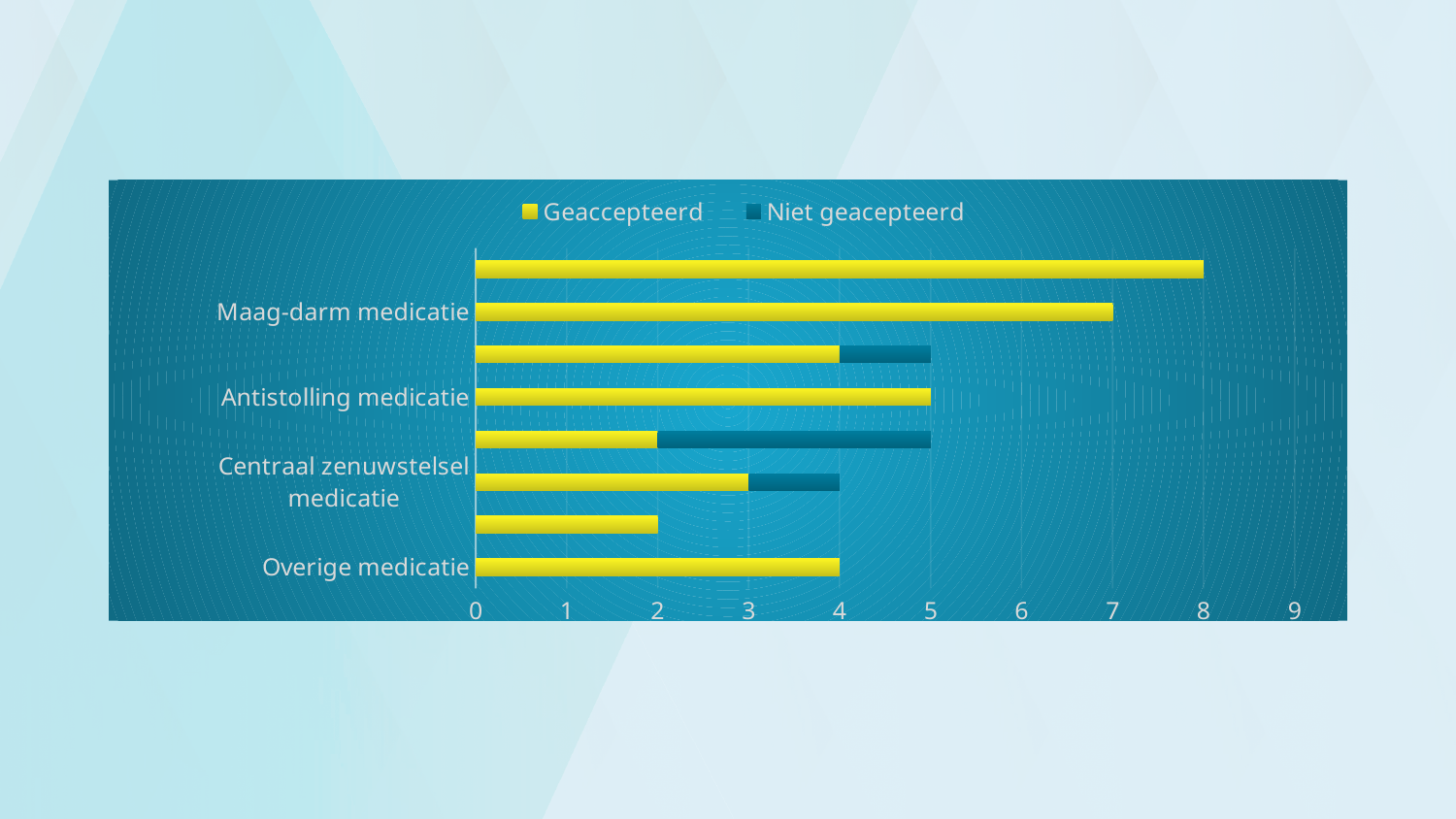
What kind of chart is shown on the slide? bar chart Which colour represents the Geaccepteerd series? yellow What is the total length of the bar for Centraal zenuwstelsel medicatie? 4 How many bars are plotted in the chart? 8 Is the Geaccepteerd value for Maag-darm medicatie greater or less than 5? greater Which is larger, the Geaccepteerd value for Maag-darm medicatie or for Overige medicatie? Maag-darm medicatie What are the two series named in the legend? Geaccepteerd and Niet geacepteerd What is the Geaccepteerd value for Maag-darm medicatie? 7 How many series does the legend list? 2 What is the Geaccepteerd value for Overige medicatie? 4 What is the value of the longest bar in the chart? 8 What is the Geaccepteerd value for Antistolling medicatie? 5